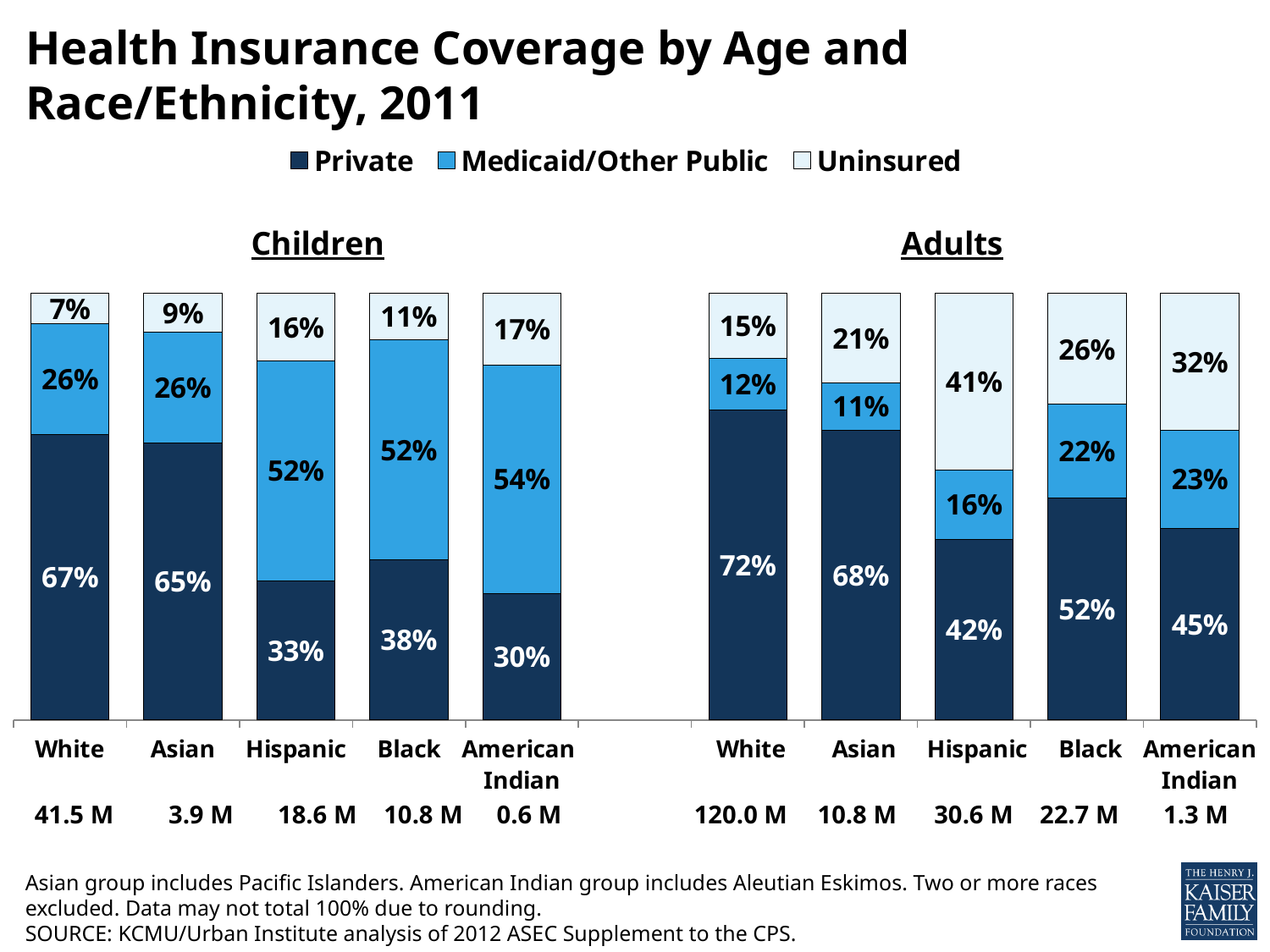
In the Adults chart, what do the three segments of the Asian bar add up to? 100% In the Adults chart, which racial/ethnic group has the lowest Private coverage share? Hispanic In the Adults chart, how many percentage points higher is the Uninsured share for American Indian adults than for White adults? 17 percentage points How many series does the legend list? 3 Which legend entry is shown in the darkest blue colour? Private What kind of chart is used to show the Adults data? Stacked bar chart In the Children chart, what is the Private coverage share for Hispanic children? 33% How many racial/ethnic groups are shown in the Children chart? 5 In the Adults chart, what is the Uninsured share for Hispanic adults? 41% In the Children chart, which racial/ethnic group has the highest Private coverage share? White In the Children chart, which group has a larger Uninsured share, Hispanic or Black? Hispanic In the Children chart, what is the Medicaid/Other Public share for American Indian children? 54%